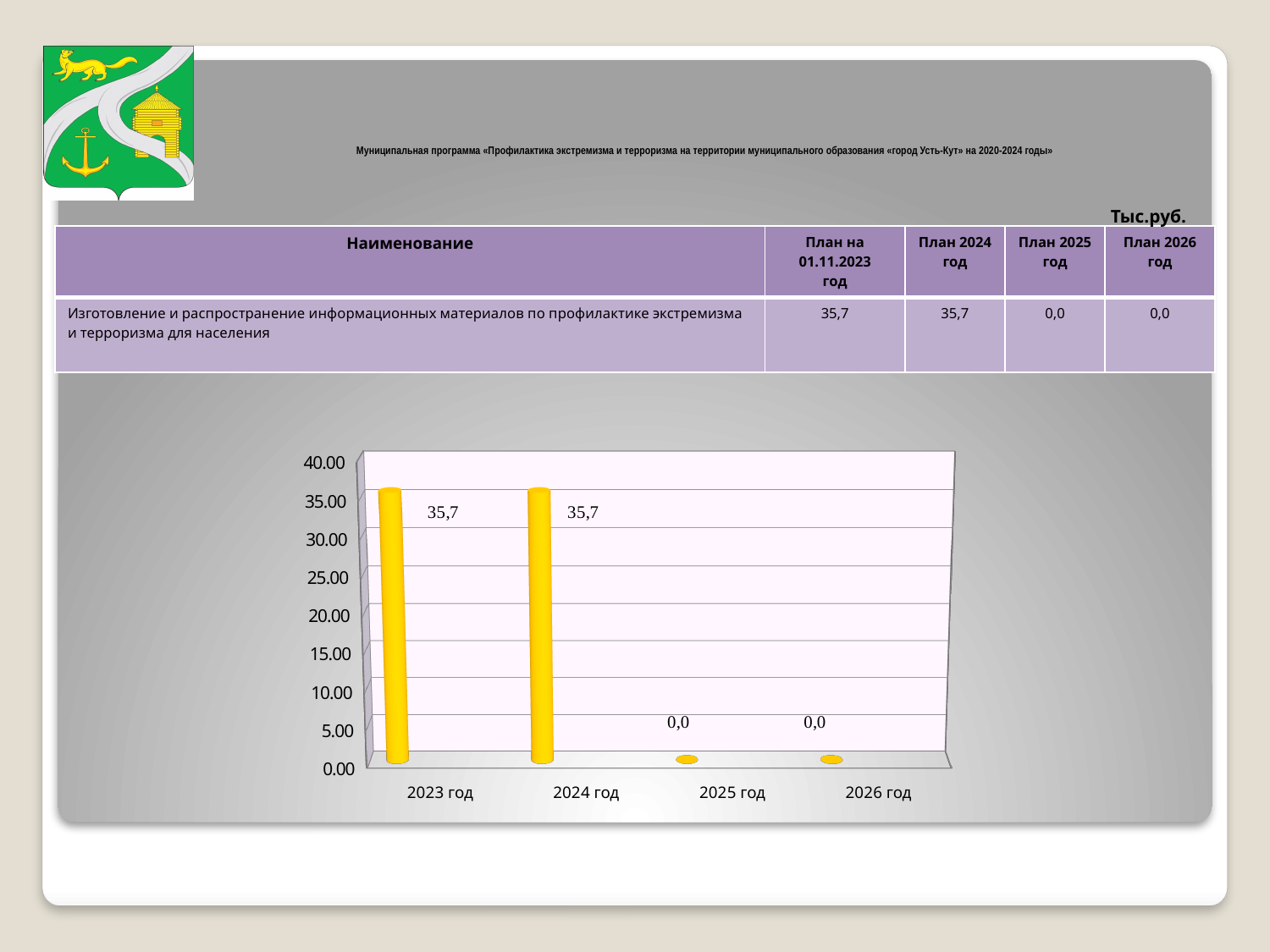
What kind of chart is shown on the slide? bar chart What is the difference between the values for 2024 год and 2025 год? 35,7 Do the values rise or fall from 2023 год to 2026 год? fall What is the difference between the values for 2023 год and 2024 год? 0,0 What is the value for 2025 год? 0,0 What is the value for 2024 год? 35,7 How many categories are shown on the x axis of the chart? 4 What is the value for 2023 год? 35,7 Which is larger, the value for 2024 год or the value for 2026 год? 2024 год Is the value for 2023 год greater or less than 30.00? greater Which is larger, the value for 2023 год or the value for 2025 год? 2023 год What is the value for 2026 год? 0,0